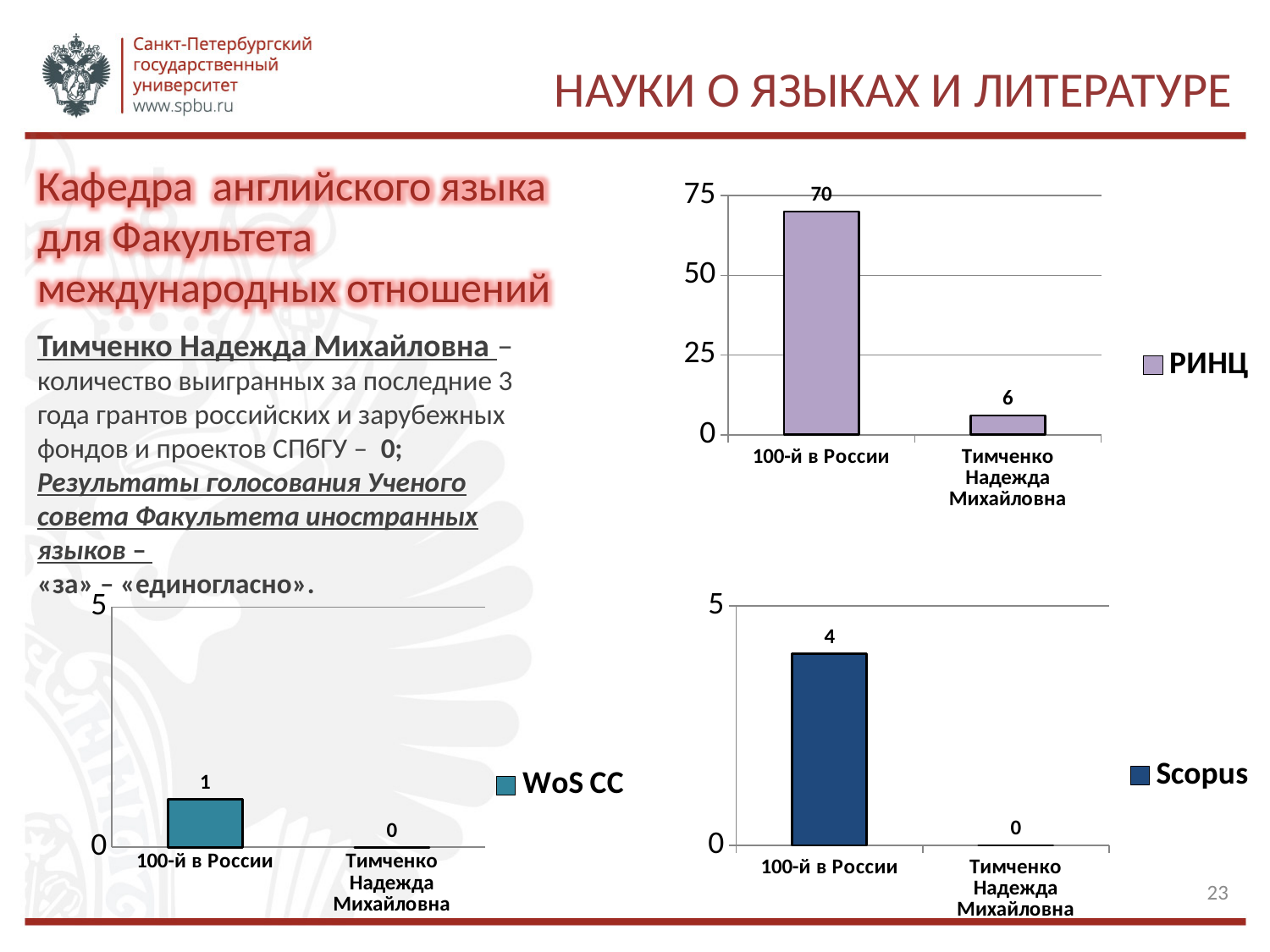
In the Scopus chart, what is the value for Тимченко Надежда Михайловна? 0 In the РИНЦ chart, which category has the highest value? 100-й в России How many categories are shown in the WoS CC chart? 2 In the WoS CC chart, what is the value for Тимченко Надежда Михайловна? 0 In the РИНЦ chart, what is the value for Тимченко Надежда Михайловна? 6 In the РИНЦ chart, what is the value for 100-й в России? 70 In the РИНЦ chart, what is the difference between the values for 100-й в России and Тимченко Надежда Михайловна? 64 In the Scopus chart, what is the value for 100-й в России? 4 In the WoS CC chart, what is the value for 100-й в России? 1 In the Scopus chart, is the value for 100-й в России larger or smaller than the value for Тимченко Надежда Михайловна? larger In the Scopus chart, which category has the lowest value? Тимченко Надежда Михайловна What type of chart is the Scopus chart? bar chart